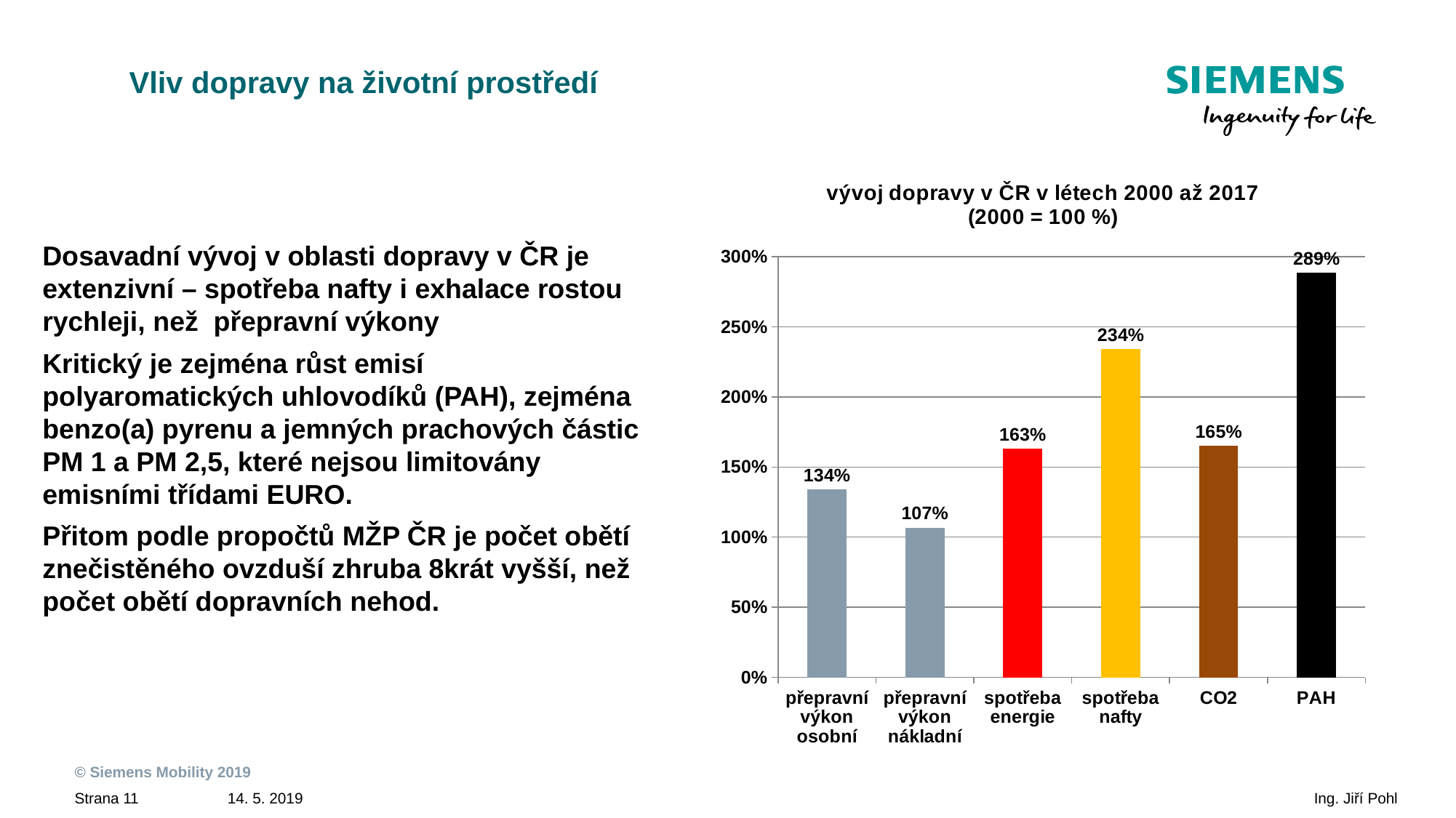
What is the title of the chart? vývoj dopravy v ČR v létech 2000 až 2017 (2000 = 100 %) Which category has the lowest value? přepravní výkon nákladní Which category has the highest value? PAH Which is larger, the value for spotřeba nafty or the value for CO2? spotřeba nafty How many categories are shown in the chart? 6 What is the value for PAH? 289% What is the value for přepravní výkon nákladní? 107% What kind of chart is shown on the slide? bar chart What is the difference between the values for spotřeba nafty and spotřeba energie? 71% What is the value for CO2? 165% What is the difference between the values for PAH and přepravní výkon osobní? 155% What is the value for spotřeba nafty? 234%